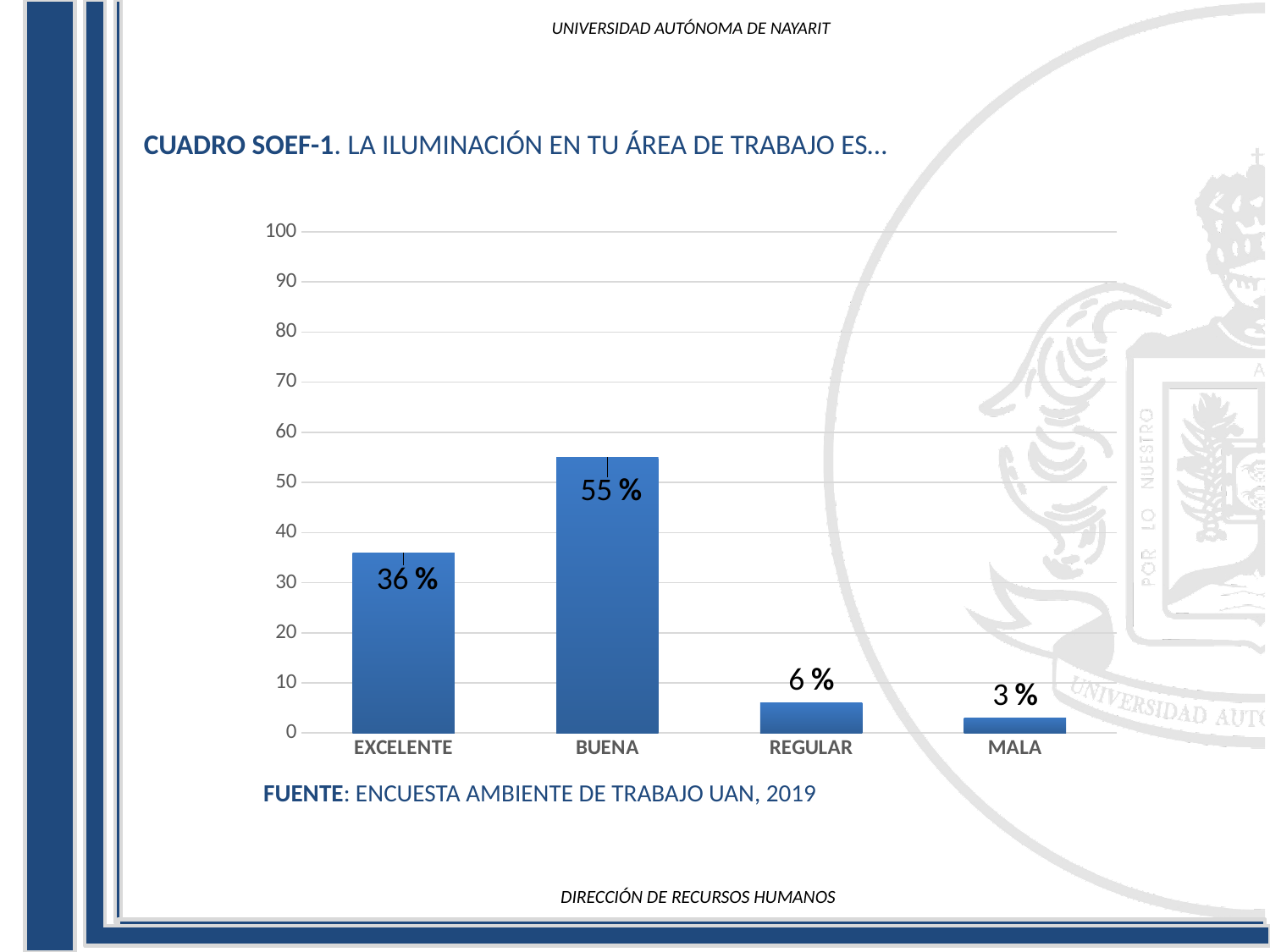
Is the value for EXCELENTE greater or less than 40? less What is the source cited below the chart? ENCUESTA AMBIENTE DE TRABAJO UAN, 2019 How many categories are shown on the x axis? 4 What is the value for BUENA? 55 % What is the value for MALA? 3 % What kind of chart is shown on the slide? bar chart Which category has the highest value? BUENA Which category has the lowest value? MALA What is the value for REGULAR? 6 % What is the value for EXCELENTE? 36 % Which is larger, the value for REGULAR or the value for MALA? REGULAR What is the difference between the values for BUENA and EXCELENTE? 19 %